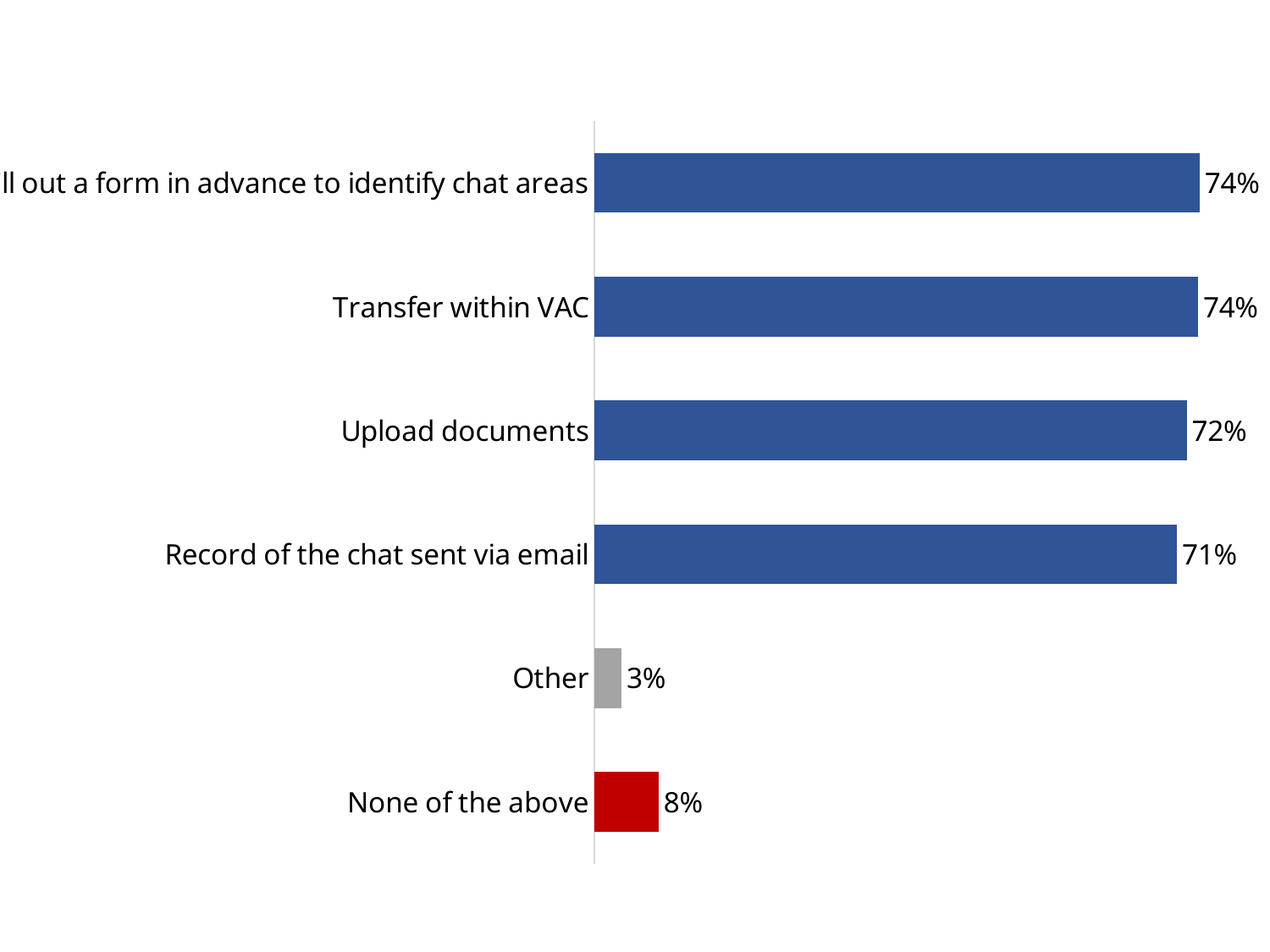
What is the value for Other? 3% How many categories are shown in the chart? 6 What kind of chart is shown on the slide? Bar chart What is the difference between the values for Transfer within VAC and Upload documents? 2% What is the value for Record of the chat sent via email? 71% Which is larger, the value for Upload documents or the value for Record of the chat sent via email? Upload documents What is the value shown for the top bar of the chart? 74% Which category has the lowest value? Other What is the value for Transfer within VAC? 74% What is the value for Upload documents? 72% What is the value for None of the above? 8% What is the difference between the values for None of the above and Other? 5%